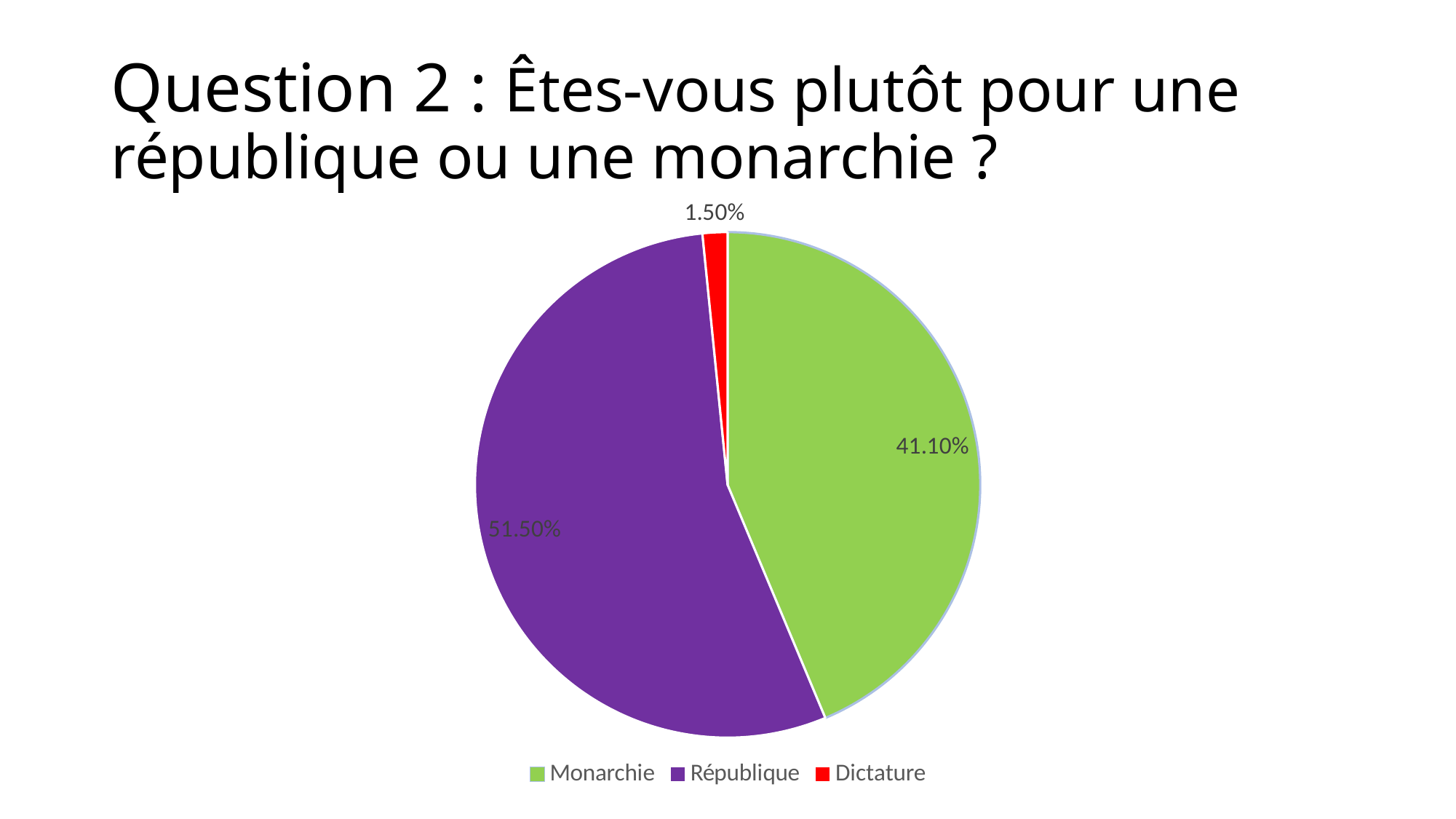
What kind of chart is shown on the slide? Pie chart What share of the pie does République represent? 51.50% What colour is the Dictature slice? Red How many categories are shown in the pie chart? 3 What share of the pie does Dictature represent? 1.50% What is the difference between the Monarchie and Dictature shares? 39.60% Which category is shown in purple in the legend? République Which category has the smallest slice of the pie? Dictature Which category has the largest slice of the pie? République Which is larger, the share for Monarchie or the share for République? République What share of the pie does Monarchie represent? 41.10% What is the difference between the République and Monarchie shares? 10.40%